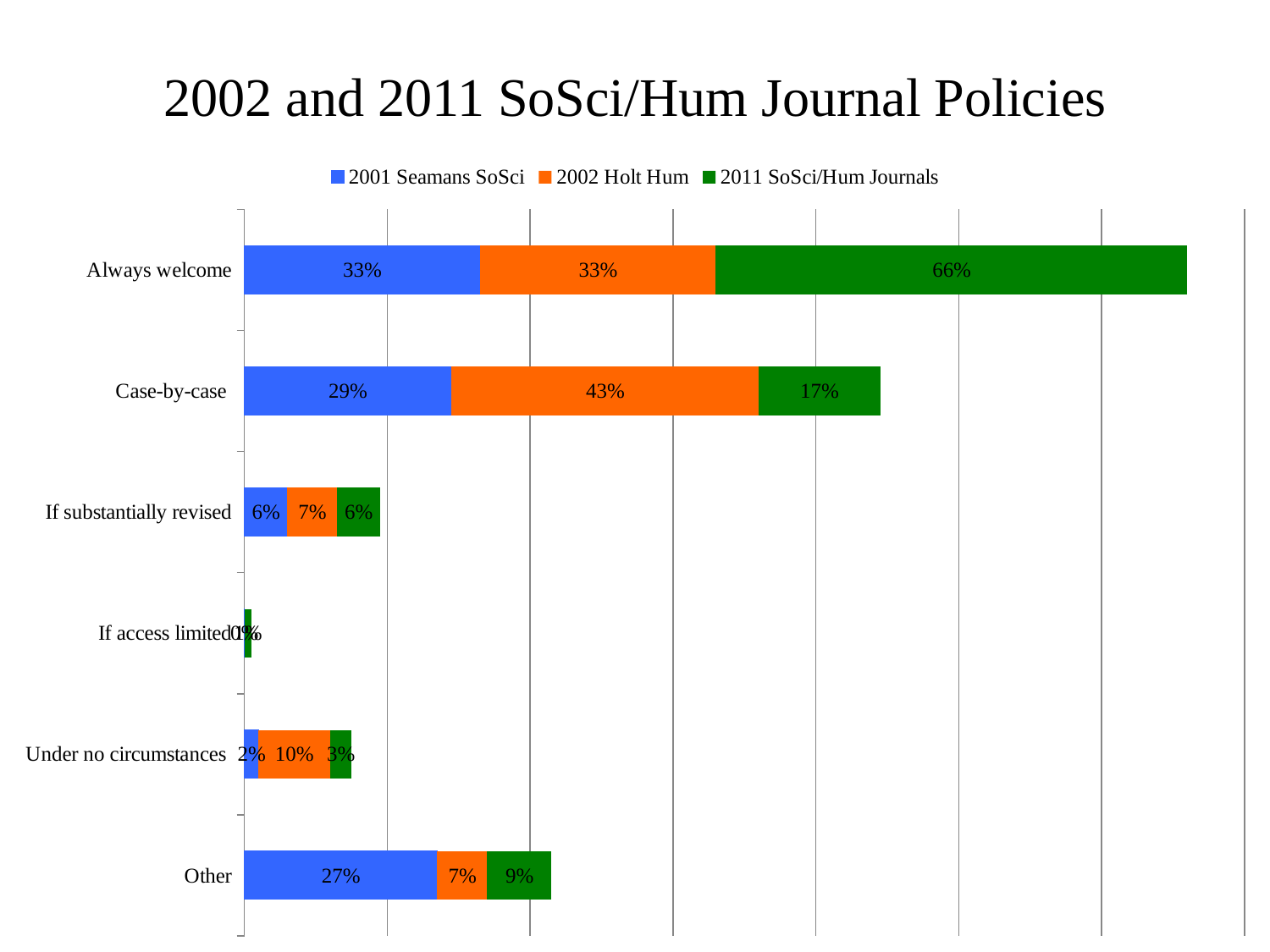
What is the difference between the 2011 SoSci/Hum Journals value and the 2001 Seamans SoSci value in the Always welcome category? 33% What is the value for 2002 Holt Hum in the Case-by-case category? 43% How many series does the legend list? 3 Which is larger in the Case-by-case category: the 2002 Holt Hum value or the 2011 SoSci/Hum Journals value? 2002 Holt Hum What is the value for 2001 Seamans SoSci in the Other category? 27% What kind of chart is shown on the slide? Stacked bar chart What is the total of the stacked bar for the Other category? 43% Which category has the highest value for 2011 SoSci/Hum Journals? Always welcome How many categories are shown on the chart? 6 What is the value for 2011 SoSci/Hum Journals in the Always welcome category? 66% What is the value for 2002 Holt Hum in the Under no circumstances category? 10%